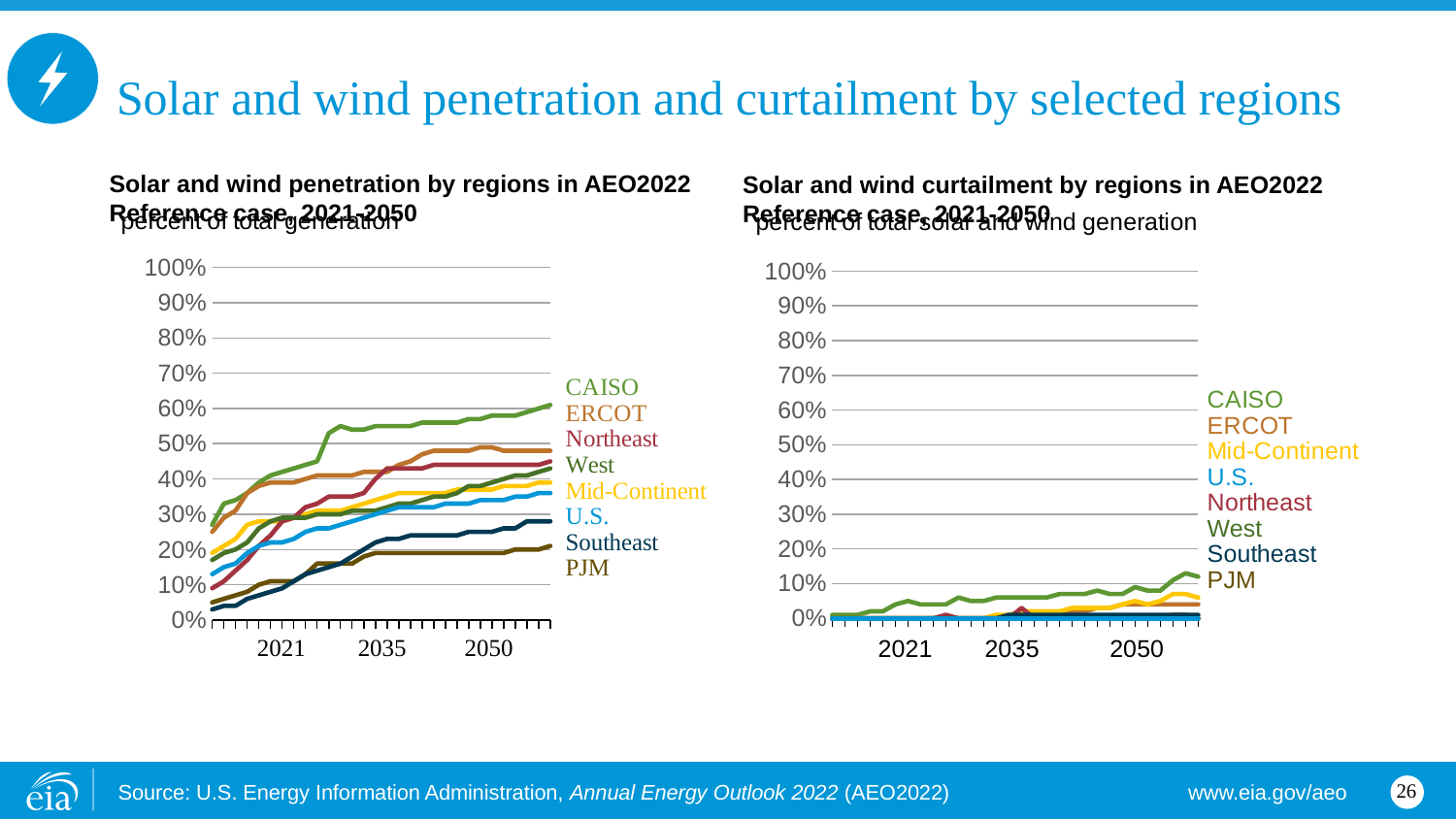
How many series does the legend of the right chart (solar and wind curtailment) list? 8 In the right chart (solar and wind curtailment), which region has the highest value in 2050? CAISO In the left chart (solar and wind penetration), which is larger in 2050: the value for CAISO or the value for Southeast? CAISO What unit is shown on the y axis of the right chart (solar and wind curtailment)? percent of total solar and wind generation In the left chart (solar and wind penetration), is the value for CAISO in 2050 greater or less than 50%? greater How many series does the legend of the left chart (solar and wind penetration) list? 8 In the left chart (solar and wind penetration), which region has the highest value in 2050? CAISO In the left chart (solar and wind penetration), which region has the lowest value in 2050? PJM In the right chart (solar and wind curtailment), is the value for CAISO in 2050 greater or less than 20%? less What kind of chart is the left chart, 'Solar and wind penetration by regions in AEO2022 Reference case, 2021-2050'? line chart In the left chart (solar and wind penetration), do the values for the U.S. generally rise or fall from 2021 to 2050? rise In the left chart (solar and wind penetration), is the value for PJM in 2050 greater or less than 30%? less